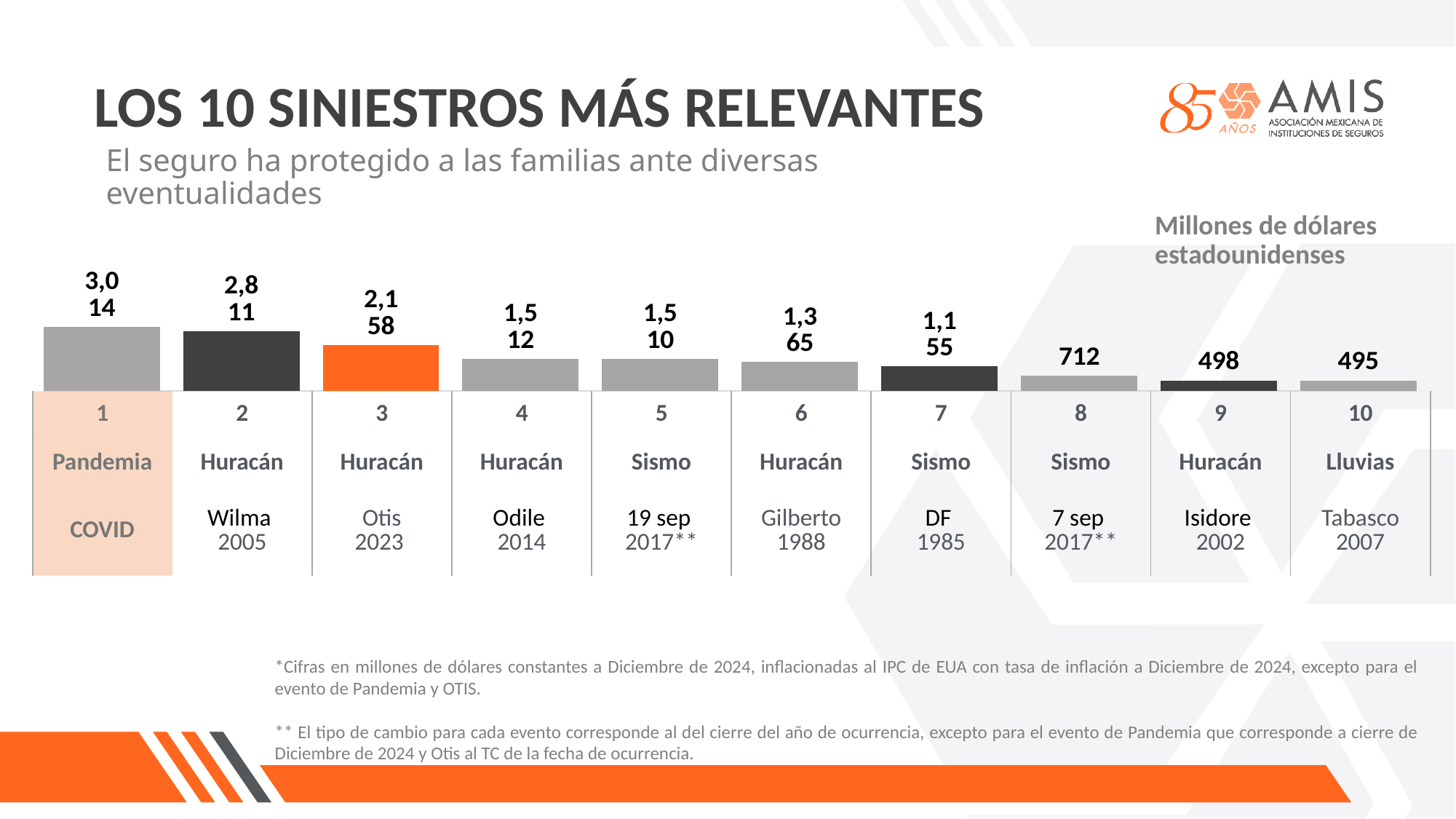
What is the value shown for Huracán Otis 2023? 2,158 What is the difference between the values for Huracán Wilma 2005 and Huracán Otis 2023? 653 What kind of chart is shown on the slide? Bar chart Which has a larger value, Huracán Odile 2014 or Huracán Gilberto 1988? Huracán Odile 2014 Do the values rise or fall from left to right across the chart? Fall What is the value shown for Sismo 7 sep 2017? 712 What is the difference between the values for Huracán Isidore 2002 and Lluvias Tabasco 2007? 3 What is the value shown for Huracán Isidore 2002? 498 Which event has the highest value in the chart? Pandemia COVID Which event has the lowest value in the chart? Lluvias Tabasco 2007 How many events are shown in the chart? 10 In what unit are the chart values expressed, according to the slide? Millones de dólares estadounidenses